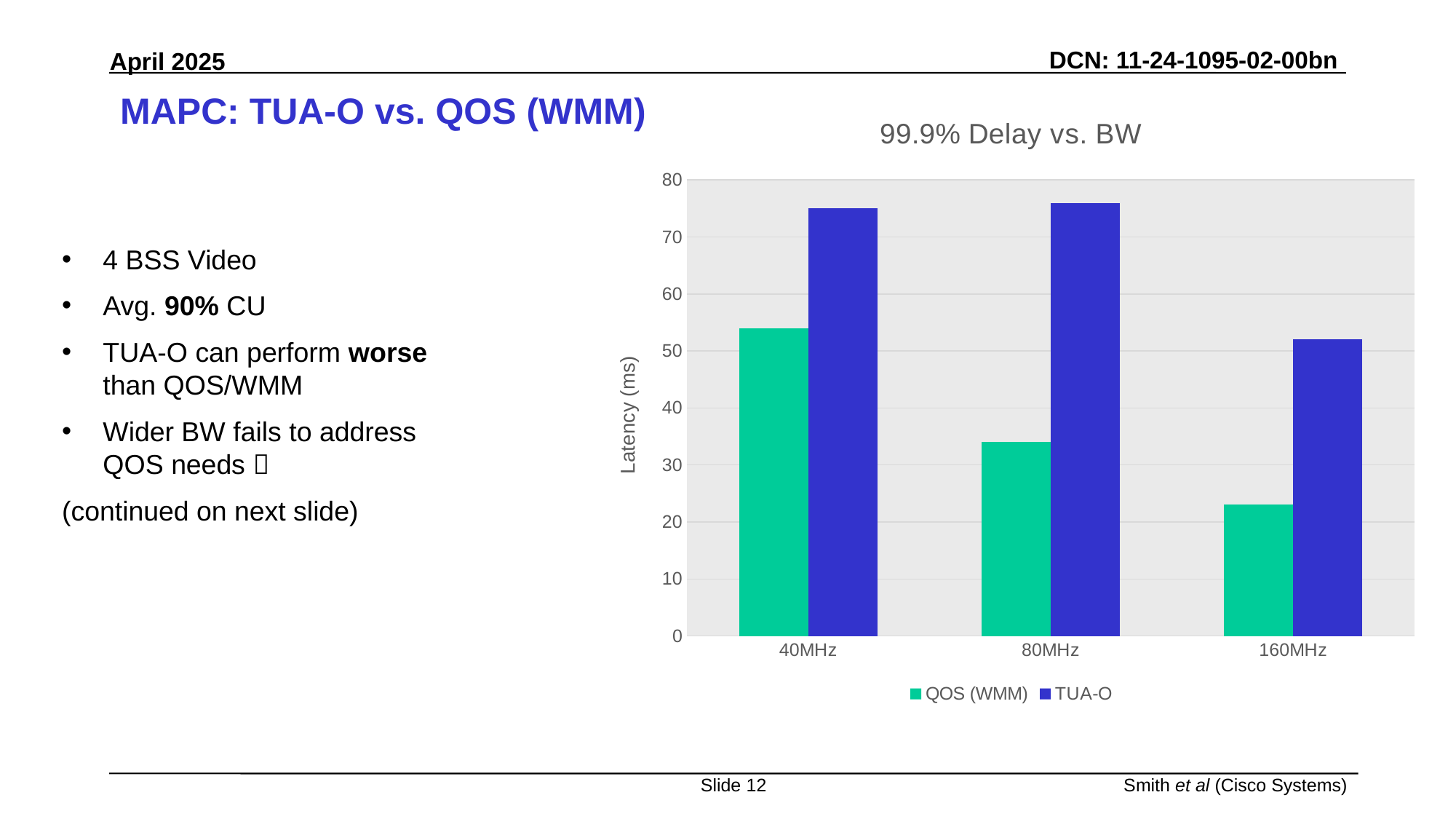
Is the QOS (WMM) latency at 40MHz greater or less than 50? greater Which bandwidth has the lowest TUA-O latency? 160MHz What kind of chart is shown on the slide? bar chart Does the QOS (WMM) latency rise or fall as bandwidth increases from 40MHz to 160MHz? fall At 80MHz, which series has the higher latency, QOS (WMM) or TUA-O? TUA-O What is the title of the chart? 99.9% Delay vs. BW How many bandwidth categories are shown on the x axis? 3 Is the QOS (WMM) latency at 160MHz greater or less than 30? less Which bandwidth has the lowest QOS (WMM) latency? 160MHz Is the TUA-O latency at 80MHz greater or less than 70? greater How many series does the chart legend list? 2 Which bandwidth has the highest QOS (WMM) latency? 40MHz